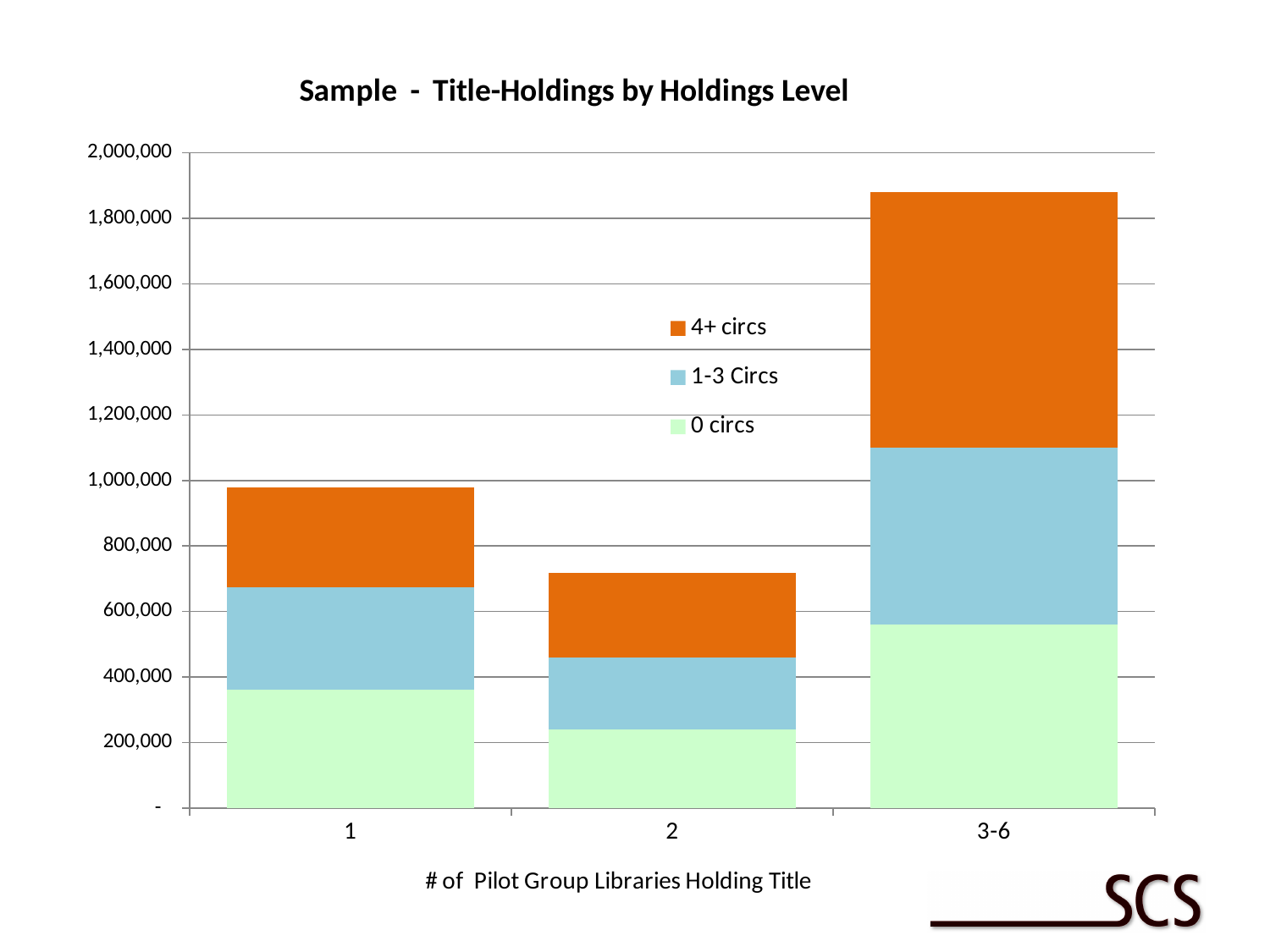
What is the title of the chart? Sample - Title-Holdings by Holdings Level What is the label of the x axis? # of Pilot Group Libraries Holding Title Is the total stacked value for category 2 greater or less than 800,000? less Which category has the larger 4+ circs segment, 1 or 3-6? 3-6 Is the 0 circs value for category 3-6 greater or less than 400,000? greater Is the total stacked value for category 3-6 greater or less than 1,800,000? greater Which category has the larger 0 circs segment, 1 or 2? 1 Which category has the shortest stacked bar overall? 2 Which category has the tallest stacked bar overall? 3-6 What kind of chart is shown on the slide? Stacked bar chart How many categories are shown on the x axis? 3 How many series does the legend list? 3